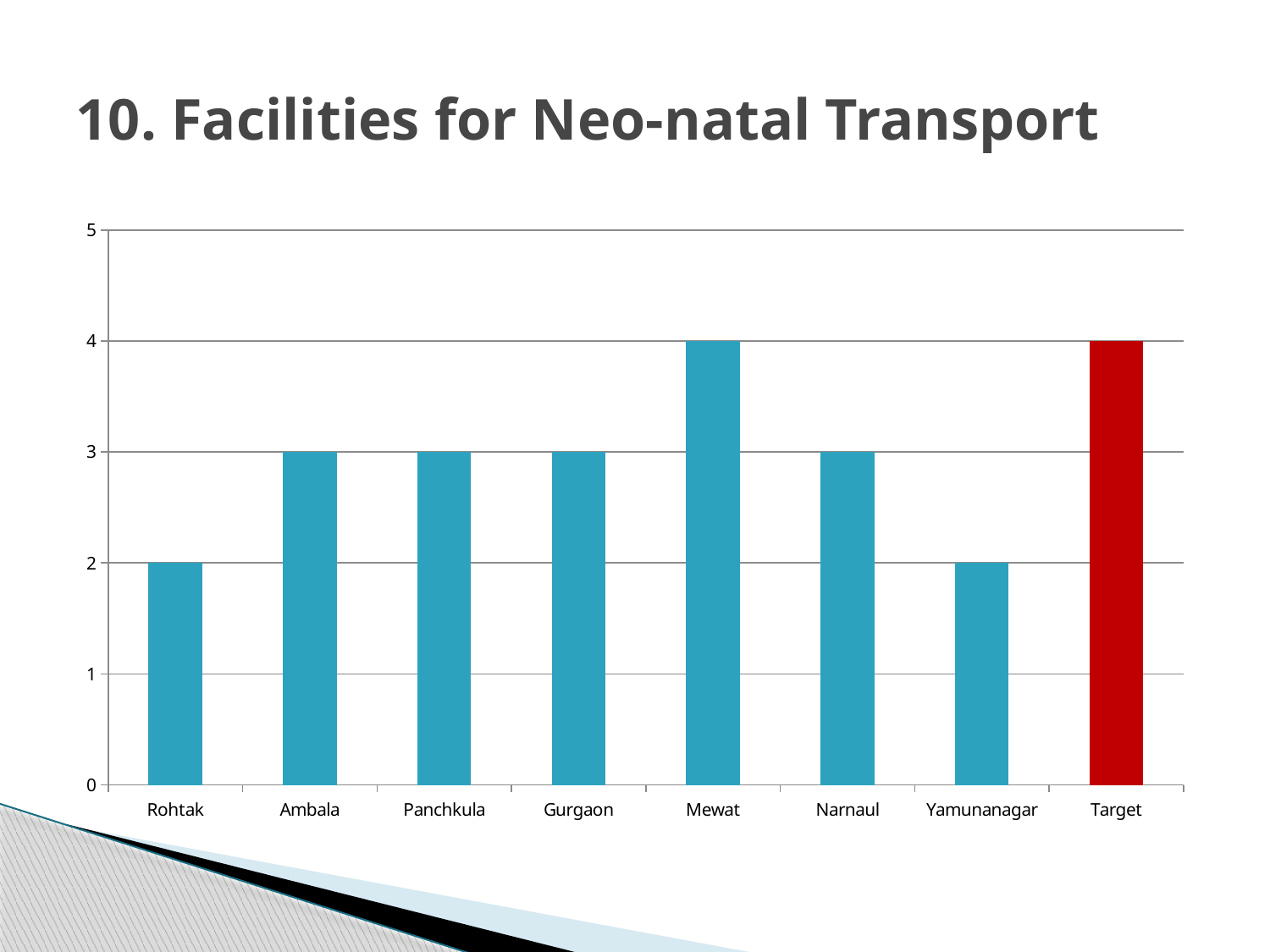
What kind of chart is shown on the slide? Bar chart What is the value for Yamunanagar? 2 Among the districts (excluding Target), which has the highest value? Mewat What is the value for Gurgaon? 3 What is the difference between the values for Mewat and Rohtak? 2 Which is larger, the value for Mewat or the value for Ambala? Mewat What colour is the Target bar? Red What is the value for Rohtak? 2 What is the value for Mewat? 4 What is the value for the Target bar? 4 What is the difference between the Target value and the value for Yamunanagar? 2 How many bars are shown on the chart? 8